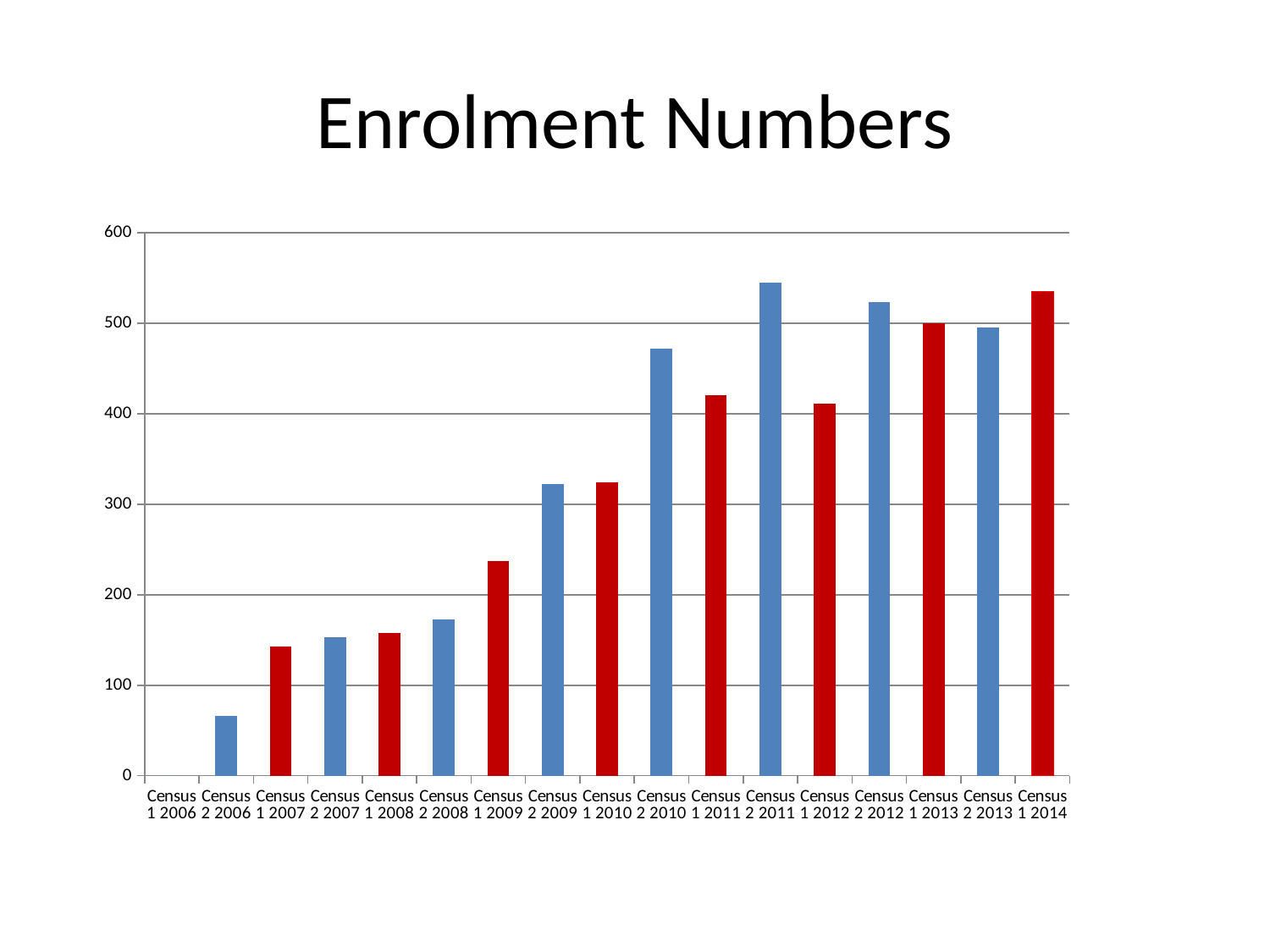
Is the value for Census 2 2011 greater or less than 500? greater Which is larger, the value for Census 2 2010 or the value for Census 1 2011? Census 2 2010 How many census periods are shown along the x axis? 17 What is the title of the chart? Enrolment Numbers Is the value for Census 1 2009 greater or less than 300? less Is the value for Census 2 2006 greater or less than 100? less Do the enrolment numbers generally rise or fall from Census 2 2006 to Census 1 2014? Rise Which is larger, the value for Census 2 2011 or the value for Census 1 2012? Census 2 2011 What kind of chart is shown on the slide? Bar chart What two colours are used for the bars in the chart? Blue and red